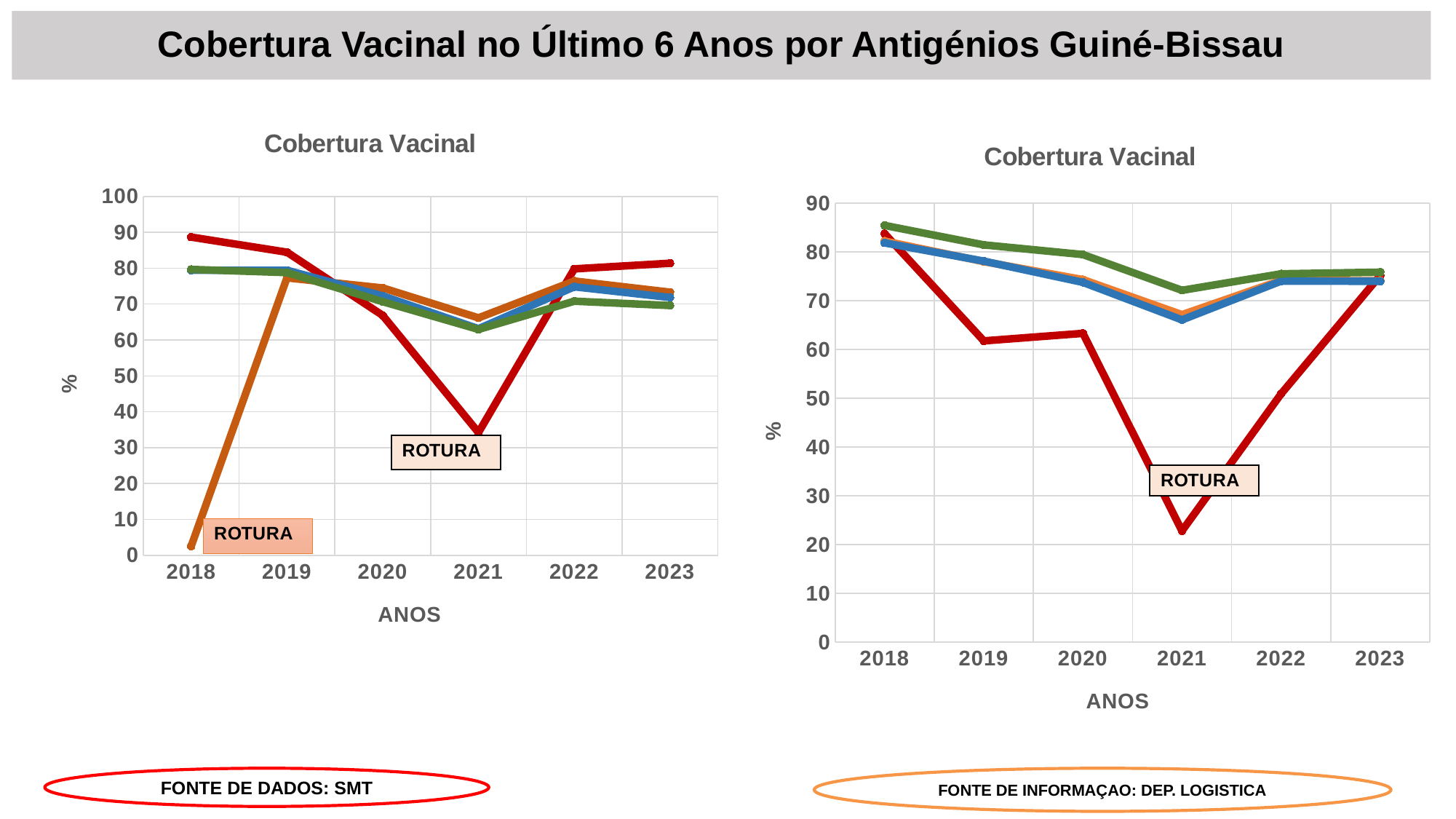
In the right chart, does the red line rise or fall from 2021 to 2023? rise In the left chart, is the value of the red line in 2021 greater or less than 40? less In the left chart, does the red line rise or fall from 2018 to 2021? fall In the right chart, how many years are shown on the x axis? 6 What kind of chart is the right chart titled 'Cobertura Vacinal'? line chart In the right chart, is the value of the red line in 2021 greater or less than 30? less In the right chart, is the value of the green line in 2018 greater or less than 80? greater What is the x-axis title of the left chart? ANOS In the left chart, how many years are shown on the x axis? 6 What kind of chart is the left chart titled 'Cobertura Vacinal'? line chart